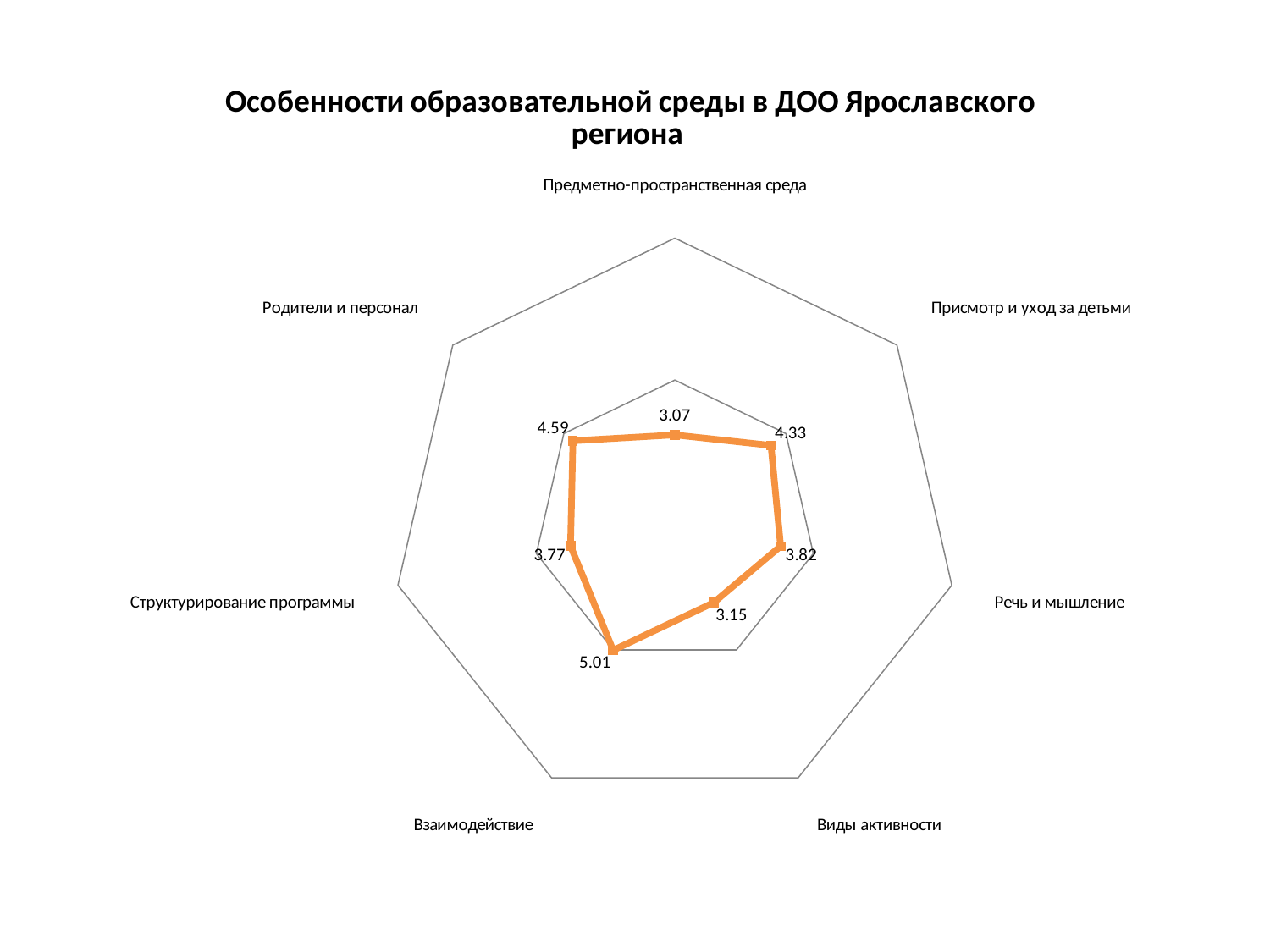
What is the value for Родители и персонал? 4.59 Which is larger, the value for Родители и персонал or the value for Присмотр и уход за детьми? Родители и персонал What is the value for Речь и мышление? 3.82 What is the value for Предметно-пространственная среда? 3.07 What kind of chart is shown on the slide? radar chart How many categories are plotted on the chart? 7 What is the difference between the values for Взаимодействие and Виды активности? 1.86 Which category has the highest value? Взаимодействие What is the title of the chart? Особенности образовательной среды в ДОО Ярославского региона What is the value for Взаимодействие? 5.01 Which category has the lowest value? Предметно-пространственная среда What is the value for Присмотр и уход за детьми? 4.33